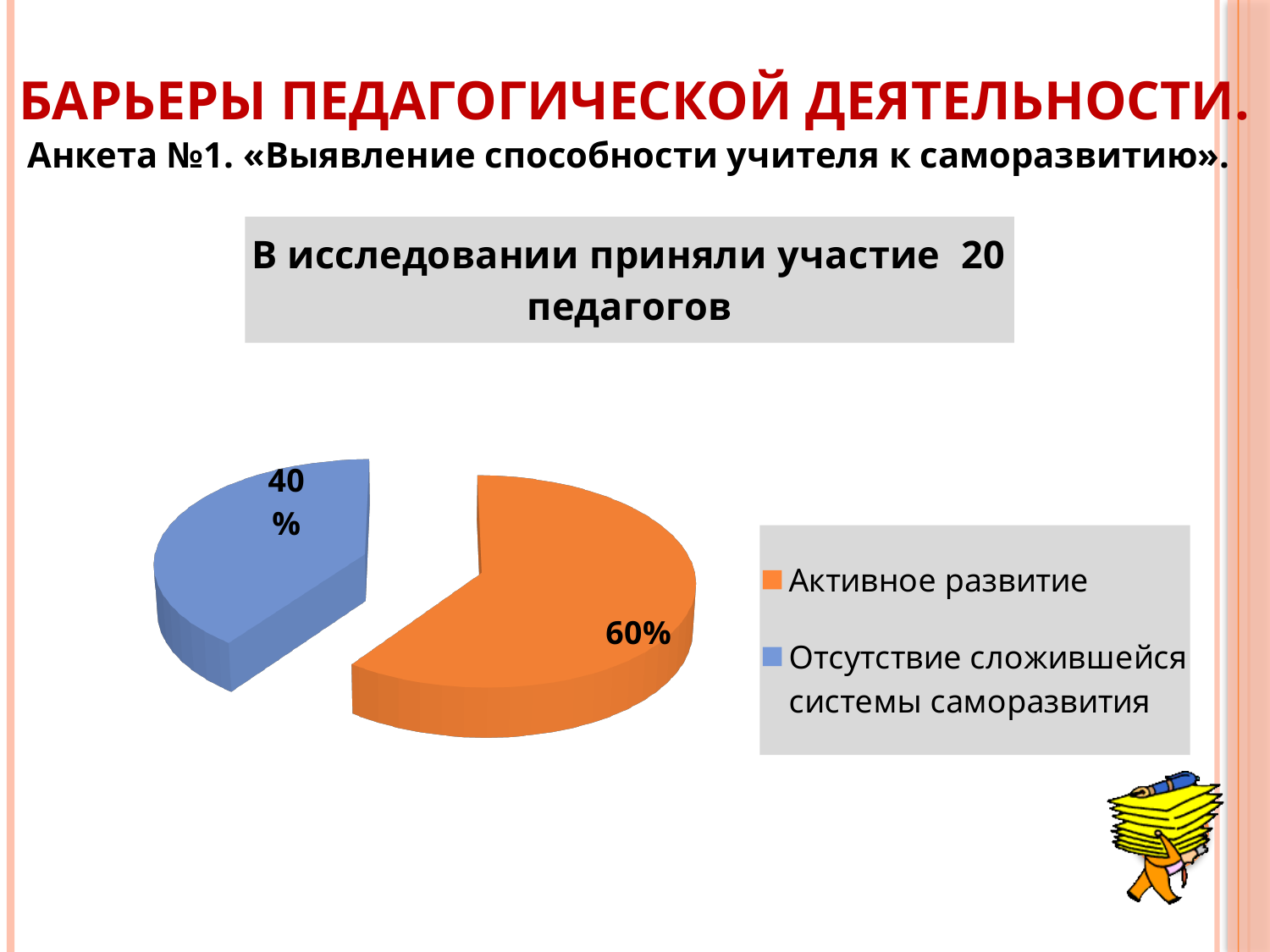
Which slice of the pie is the smallest? Отсутствие сложившейся системы саморазвития What share of the pie does "Активное развитие" have? 60% Is the share for "Активное развитие" greater or less than 50%? greater What is the difference in percentage points between the "Активное развитие" slice and the "Отсутствие сложившейся системы саморазвития" slice? 20 What colour is the "Отсутствие сложившейся системы саморазвития" slice? blue Which slice of the pie is the largest? Активное развитие What share of the pie does "Отсутствие сложившейся системы саморазвития" have? 40% Which is larger: the share for "Активное развитие" or the share for "Отсутствие сложившейся системы саморазвития"? Активное развитие What colour is the "Активное развитие" slice? orange How many slices does the pie chart have? 2 How many entries does the legend list? 2 What kind of chart is shown on the slide? pie chart